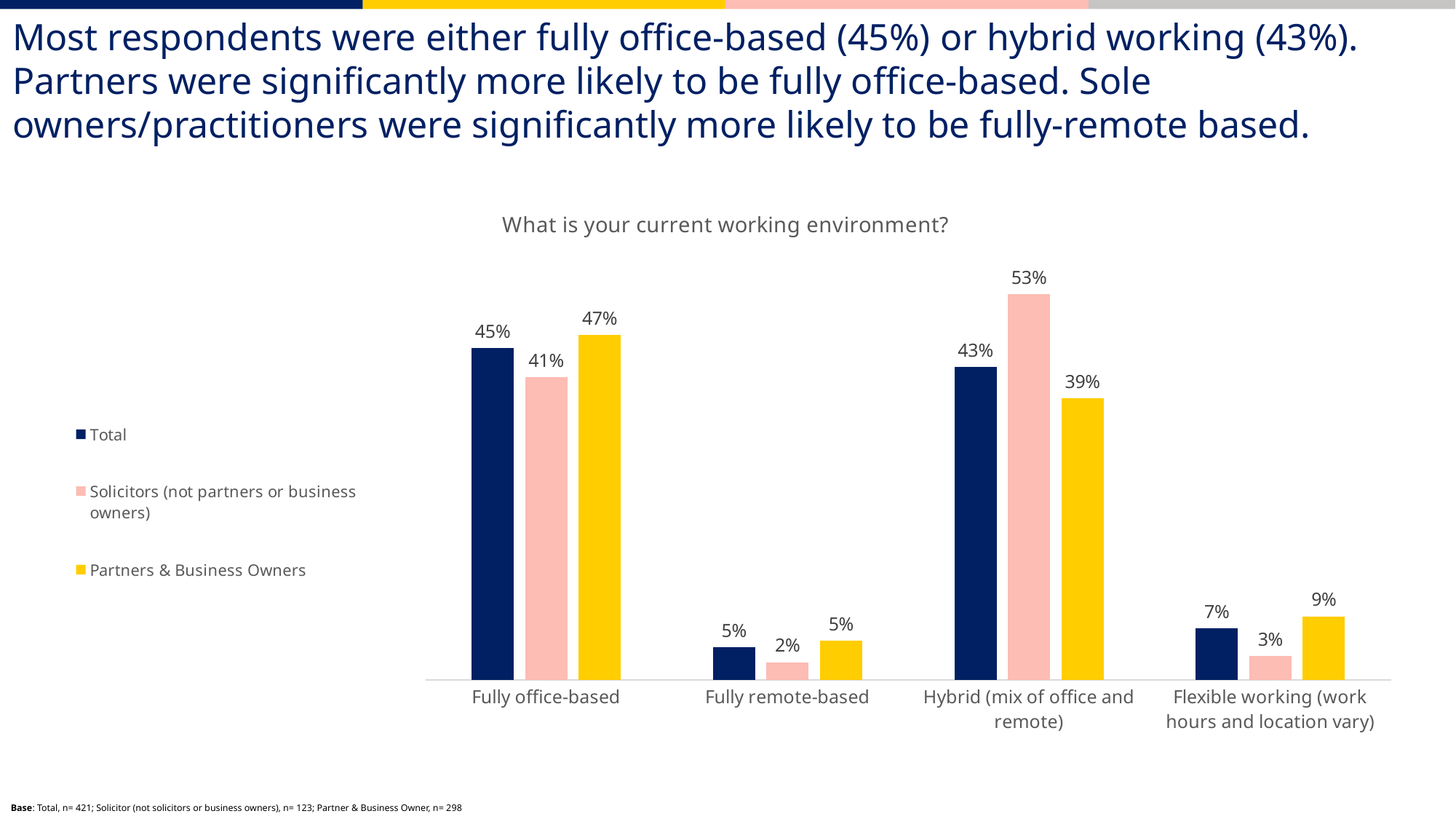
Which category has the lowest value for Solicitors (not partners or business owners)? Fully remote-based How many categories are shown on the x axis? 4 What is the difference between the Partners & Business Owners and Solicitors values for Fully office-based? 6% How many series does the legend list? 3 What is the value for Solicitors (not partners or business owners) in the Hybrid (mix of office and remote) category? 53% What is the title of the chart? What is your current working environment? What kind of chart is shown on the slide? Bar chart What is the value for Partners & Business Owners in the Flexible working (work hours and location vary) category? 9% What is the difference between the Solicitors and Partners & Business Owners values for Hybrid (mix of office and remote)? 14% What is the Total value for Fully office-based? 45% Which is larger for Fully remote-based: the Total value or the Solicitors value? Total Which category has the highest value for Partners & Business Owners? Fully office-based